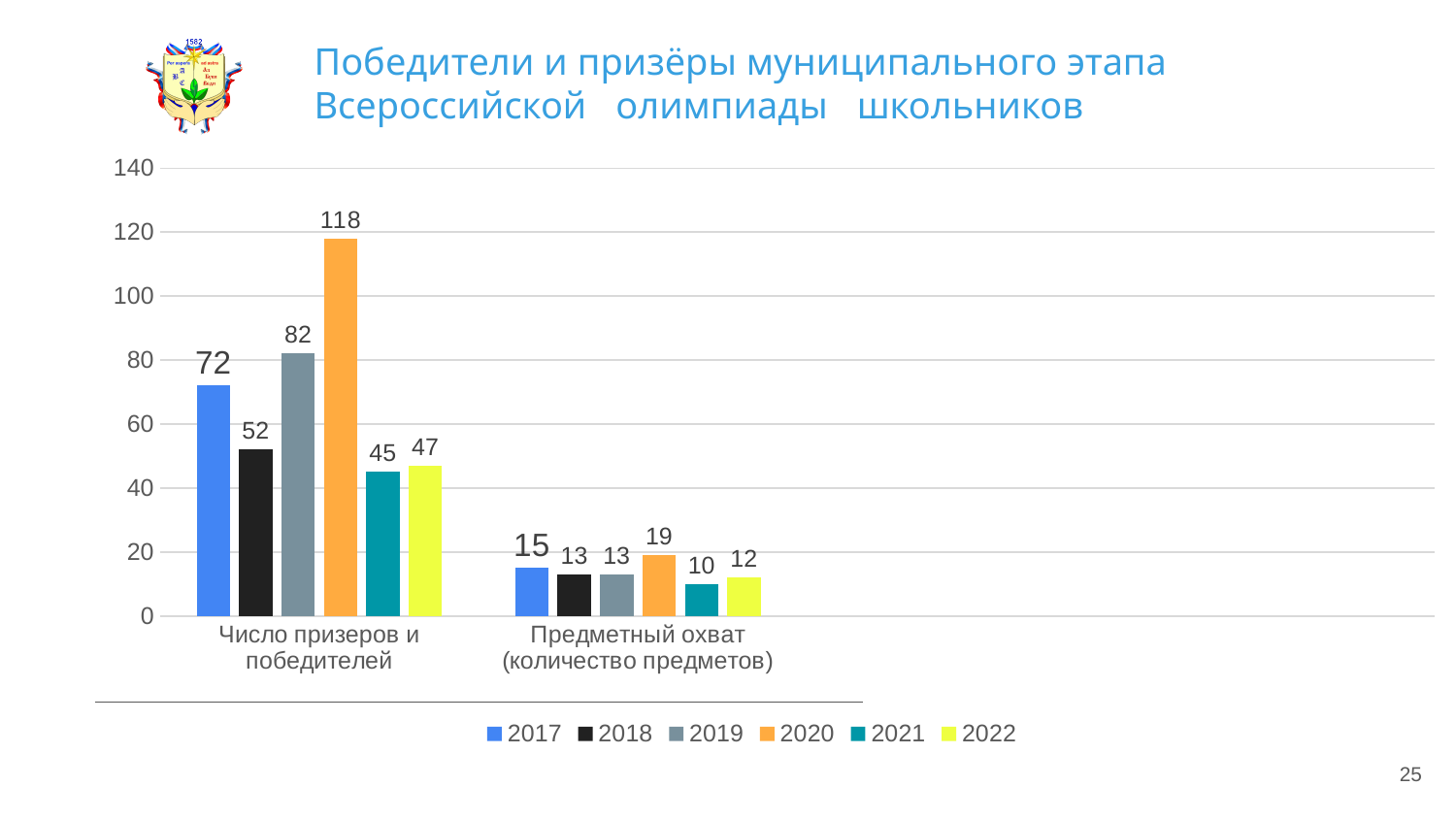
What colour represents 2020 in the legend? orange Which is larger in the "Число призеров и победителей" category: the value for 2018 or the value for 2022? 2018 What is the difference between the 2020 and 2019 values in the "Число призеров и победителей" category? 36 How many categories are shown on the x axis? 2 What kind of chart is shown on the slide? bar chart What is the value for 2020 in the "Число призеров и победителей" category? 118 How many series does the legend list? 6 What is the value for 2021 in the "Предметный охват (количество предметов)" category? 10 What is the value for 2017 in the "Число призеров и победителей" category? 72 Which year has the highest value in the "Число призеров и победителей" category? 2020 Which year has the lowest value in the "Предметный охват (количество предметов)" category? 2021 Is the value for 2019 in the "Число призеров и победителей" category greater or less than 100? less